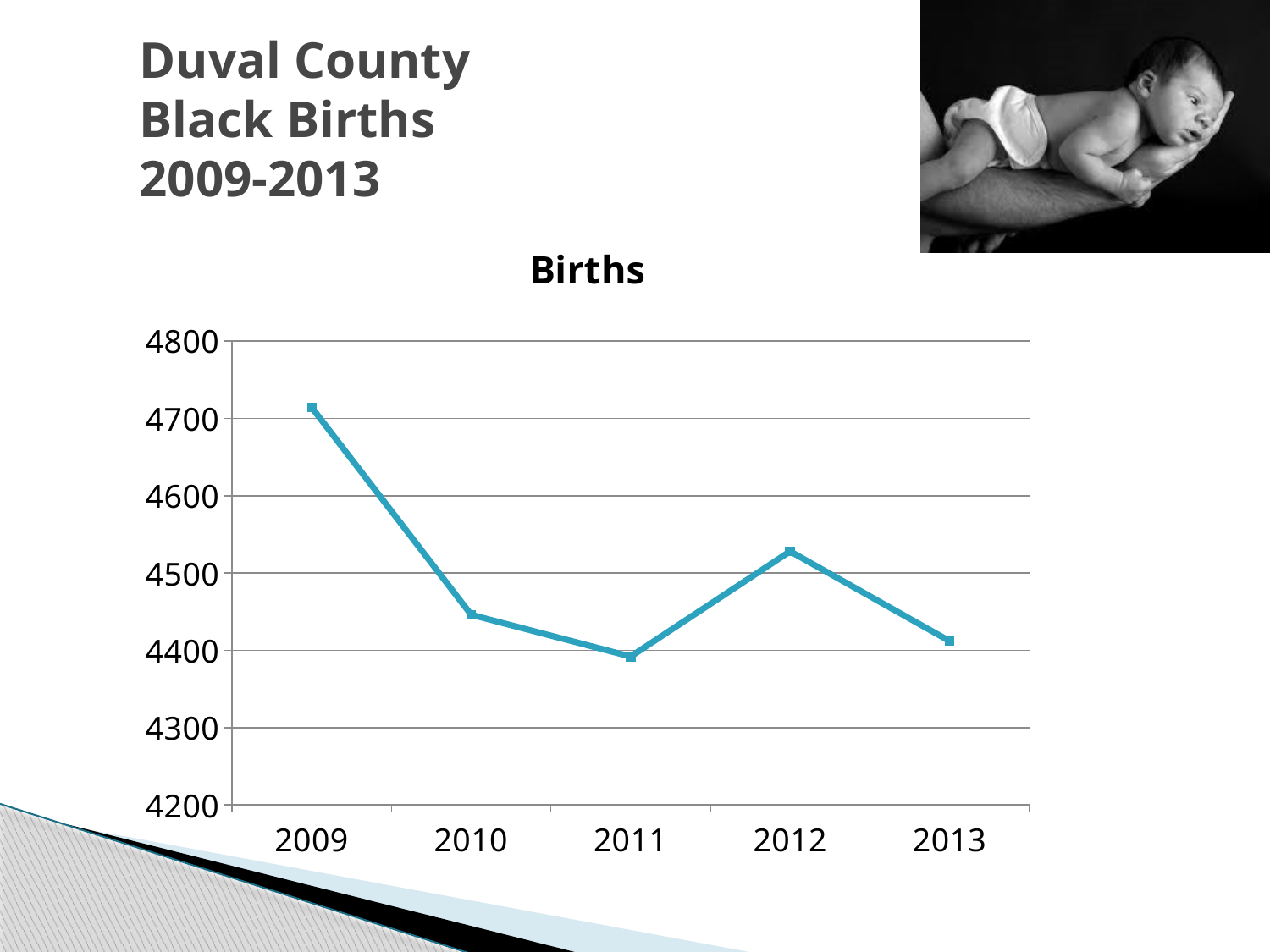
Is the value for 2013 greater or less than 4500? less Is the value for 2010 greater or less than 4500? less How many years are plotted on the x axis of the chart? 5 Do births rise or fall from 2009 to 2011? fall Which year has the highest number of births? 2009 Is the value for 2012 greater or less than 4500? greater Which year has the lowest number of births? 2011 Which year has more births, 2010 or 2012? 2012 Which year has more births, 2009 or 2012? 2009 What is the title of the chart? Births What kind of chart is shown on the slide? line chart